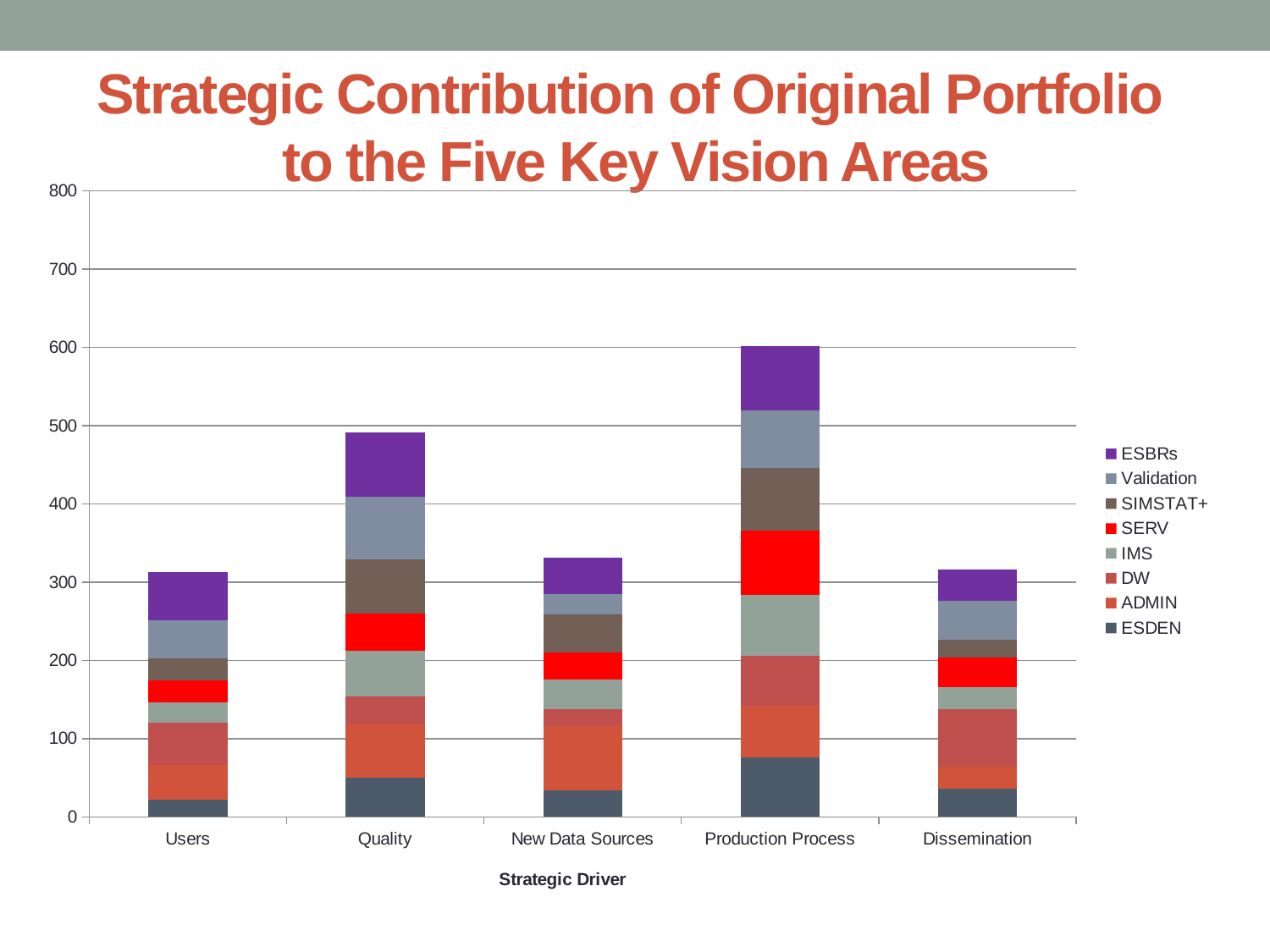
Is the total stacked value for New Data Sources greater or less than 300? greater Which has the larger total stacked bar, Production Process or Quality? Production Process Is the total stacked value for Users greater or less than 400? less Is the total stacked value for Production Process greater or less than 500? greater Which has the larger total stacked bar, Quality or New Data Sources? Quality How many categories are shown on the x axis of the chart? 5 What is the title of the chart's x axis? Strategic Driver What kind of chart is shown on the slide? Stacked bar chart How many series does the chart's legend list? 8 Which category has the tallest stacked bar? Production Process Which series is listed first (at the top) in the chart's legend? ESBRs